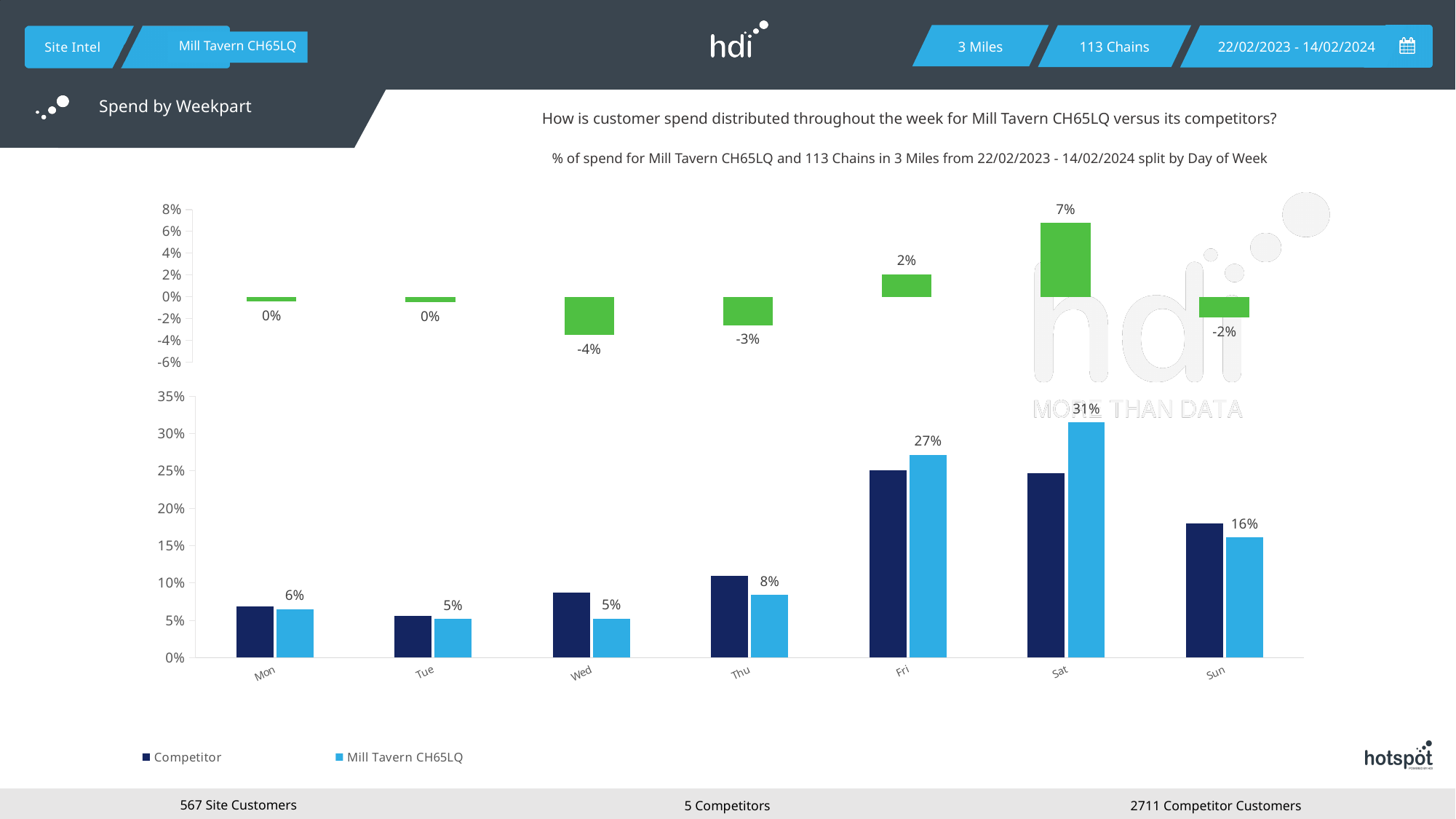
In the bottom chart, which is larger on Sun: the Competitor bar or the Mill Tavern CH65LQ bar? Competitor What kind of chart is the bottom chart? bar chart In the top chart, what is the value for Sat? 7% In the top chart, which day has the lowest value? Wed In the bottom chart, is the Competitor value for Thu greater or less than 10%? greater In the bottom chart, what is the value for Mill Tavern CH65LQ on Sat? 31% In the bottom chart, what is the difference between the Mill Tavern CH65LQ values for Sat and Fri? 4% How many series does the legend of the bottom chart list? 2 In the bottom chart, is the Competitor value for Sun greater or less than 20%? less How many days are shown on the x axis of the bottom chart? 7 In the bottom chart, what is the value for Mill Tavern CH65LQ on Thu? 8% In the bottom chart, which day has the highest value for Mill Tavern CH65LQ? Sat